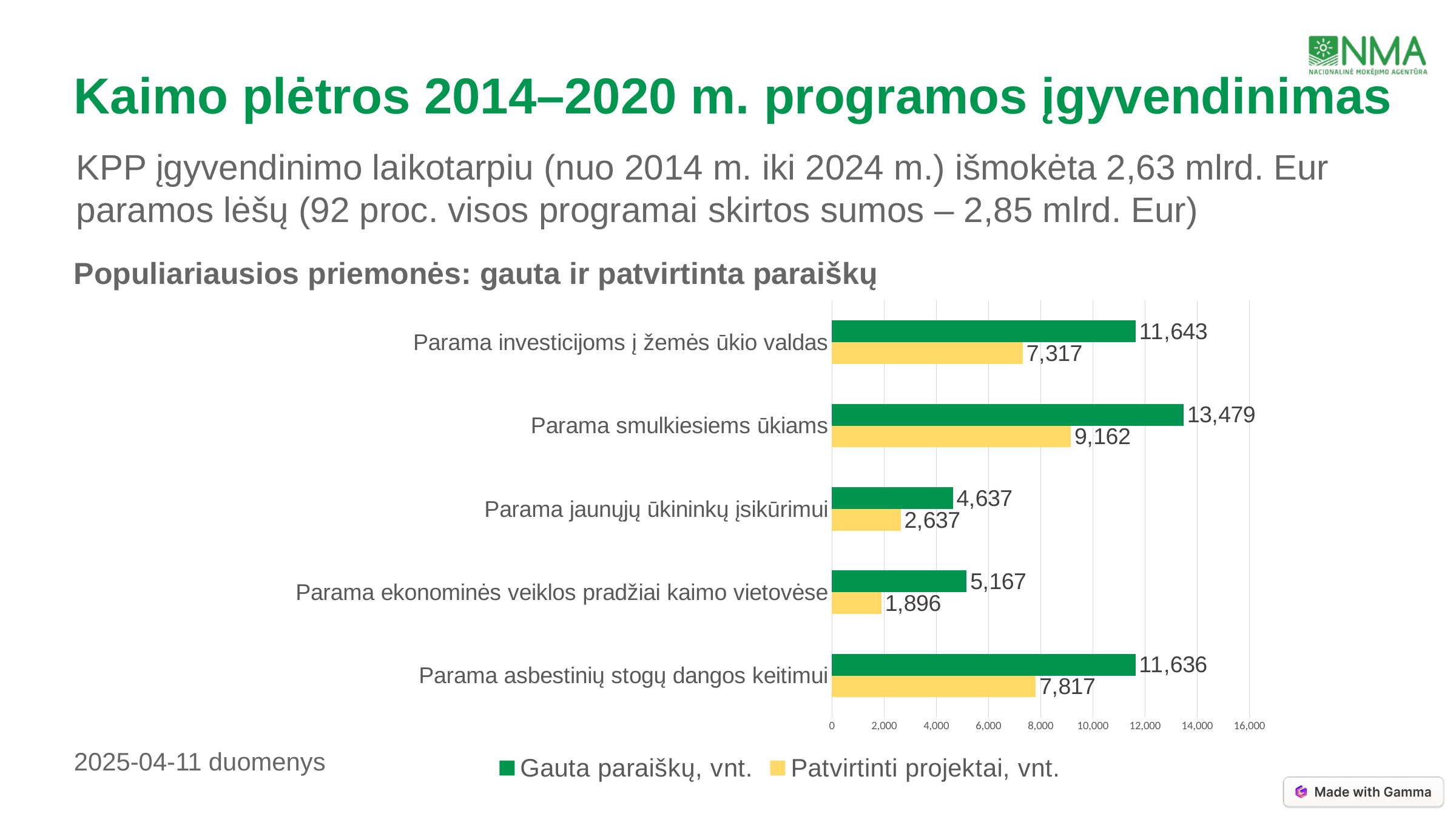
Which is larger: 'Gauta paraiškų, vnt.' for 'Parama investicijoms į žemės ūkio valdas' or for 'Parama asbestinių stogų dangos keitimui'? Parama investicijoms į žemės ūkio valdas How many series does the legend list? 2 What kind of chart is shown on the slide? bar chart Which category has the lowest value for 'Patvirtinti projektai, vnt.'? Parama ekonominės veiklos pradžiai kaimo vietovėse What colour represents 'Patvirtinti projektai, vnt.' in the chart? yellow What is the difference between 'Gauta paraiškų, vnt.' and 'Patvirtinti projektai, vnt.' for 'Parama jaunųjų ūkininkų įsikūrimui'? 2,000 What is the value of 'Patvirtinti projektai, vnt.' for 'Parama ekonominės veiklos pradžiai kaimo vietovėse'? 1,896 What is the value of 'Patvirtinti projektai, vnt.' for 'Parama asbestinių stogų dangos keitimui'? 7,817 Is the value of 'Patvirtinti projektai, vnt.' for 'Parama smulkiesiems ūkiams' greater or less than 8,000? greater How many categories are shown in the chart? 5 Which category has the highest value for 'Gauta paraiškų, vnt.'? Parama smulkiesiems ūkiams What is the value of 'Gauta paraiškų, vnt.' for 'Parama smulkiesiems ūkiams'? 13,479